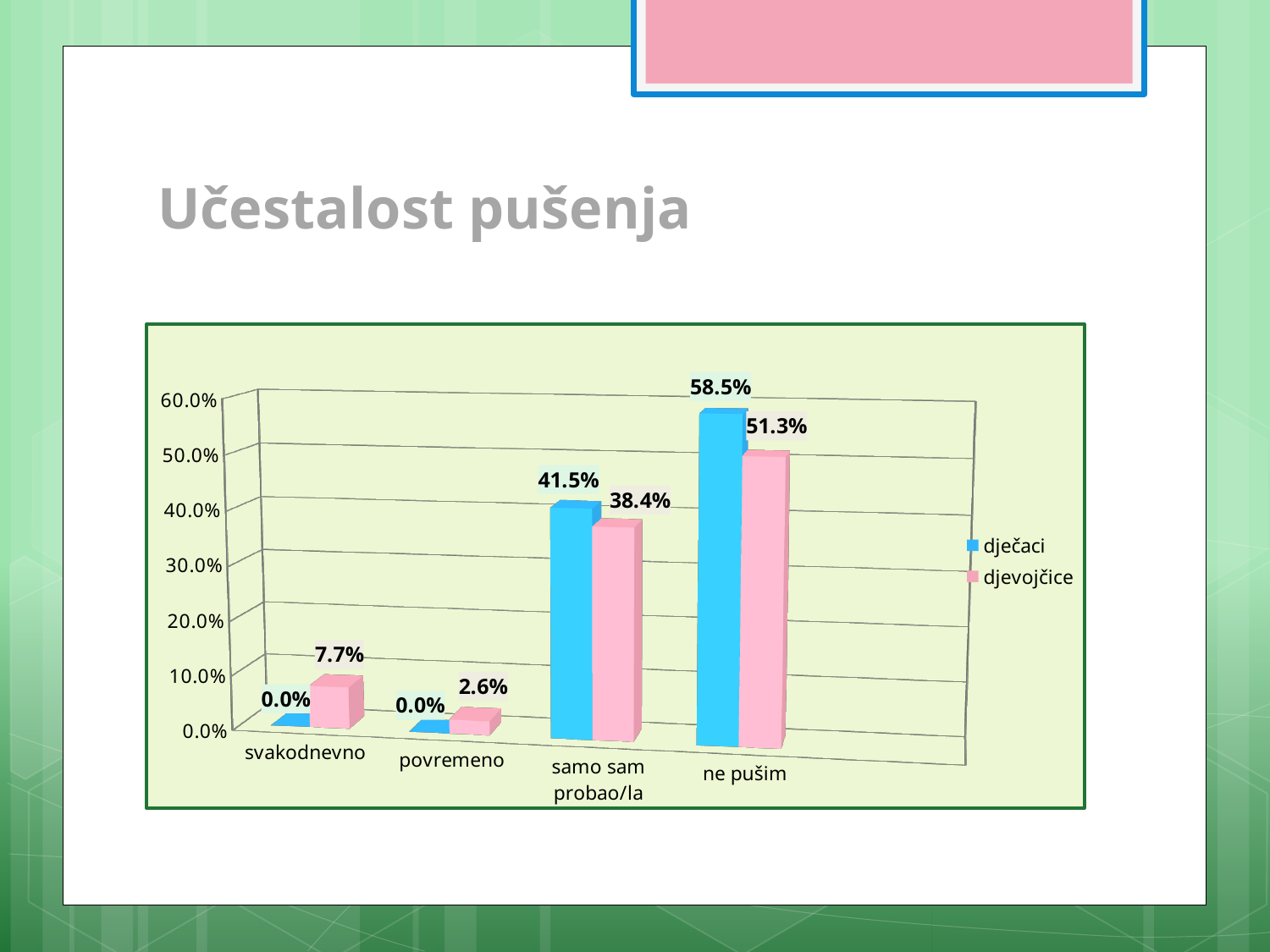
Which category has the highest value for djevojčice? ne pušim How many series does the legend list? 2 In the 'svakodnevno' category, which series has the larger value, dječaci or djevojčice? djevojčice What is the difference between dječaci and djevojčice in the 'ne pušim' category? 7.2% What kind of chart is shown on the slide? bar chart What is the value for dječaci in the 'ne pušim' category? 58.5% What is the value for djevojčice in the 'samo sam probao/la' category? 38.4% What is the difference between dječaci and djevojčice in the 'samo sam probao/la' category? 3.1% Which category has the lowest value for djevojčice? povremeno What is the value for djevojčice in the 'svakodnevno' category? 7.7% How many categories are shown on the x axis? 4 What is the value for dječaci in the 'povremeno' category? 0.0%